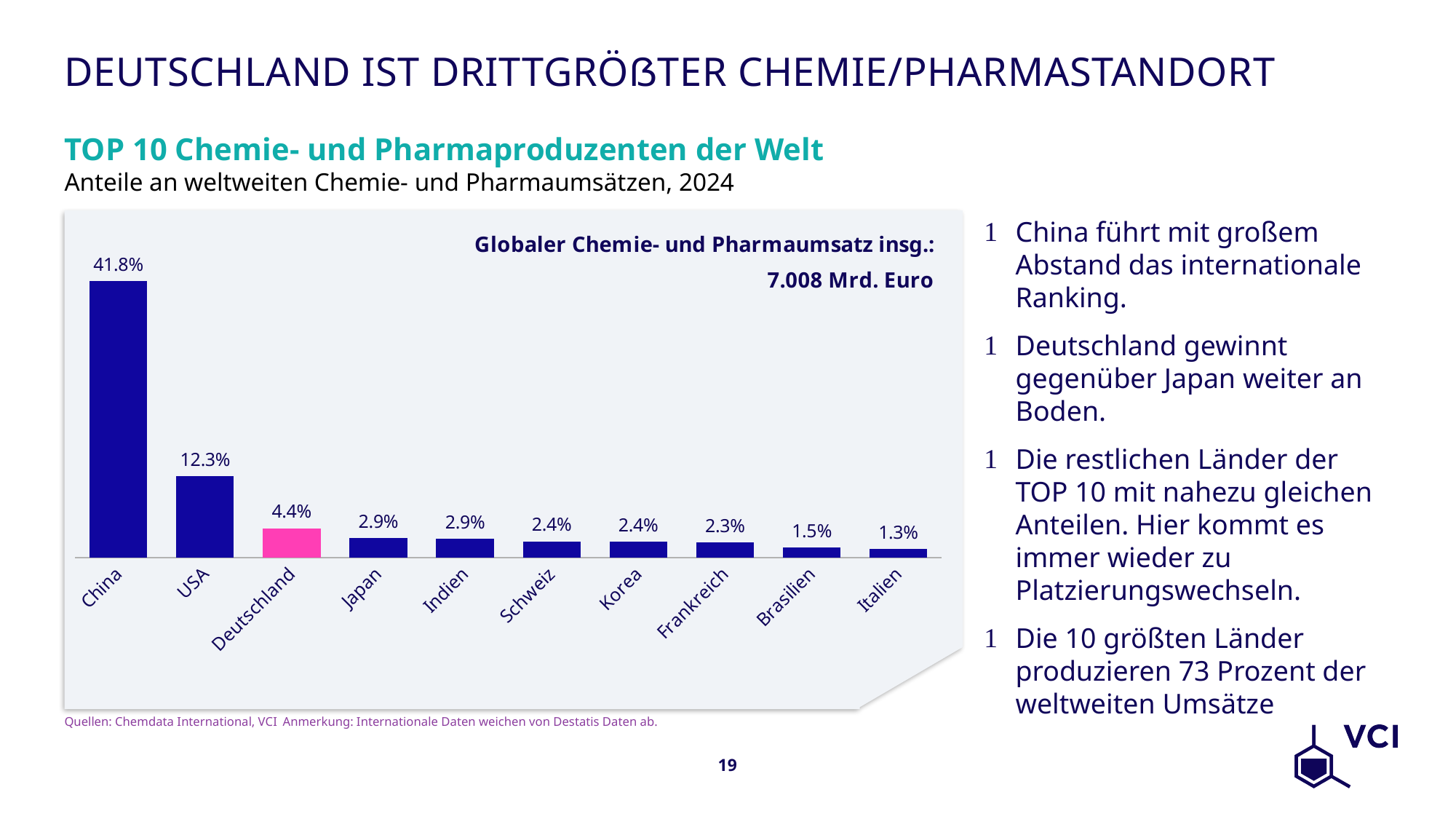
What is the value for China? 41.8% Which country has the highest share? China What is the difference between the values for Deutschland and Japan? 1.5% How many countries are shown in the chart? 10 What is the value for Frankreich? 2.3% Which is larger, the value for Brasilien or the value for Italien? Brasilien Which country has the lowest share? Italien Which is larger, the value for USA or the value for Deutschland? USA What kind of chart is shown on the slide? Bar chart What is the value for Deutschland? 4.4% What is the difference between the values for China and USA? 29.5% Which country's bar is highlighted in pink? Deutschland